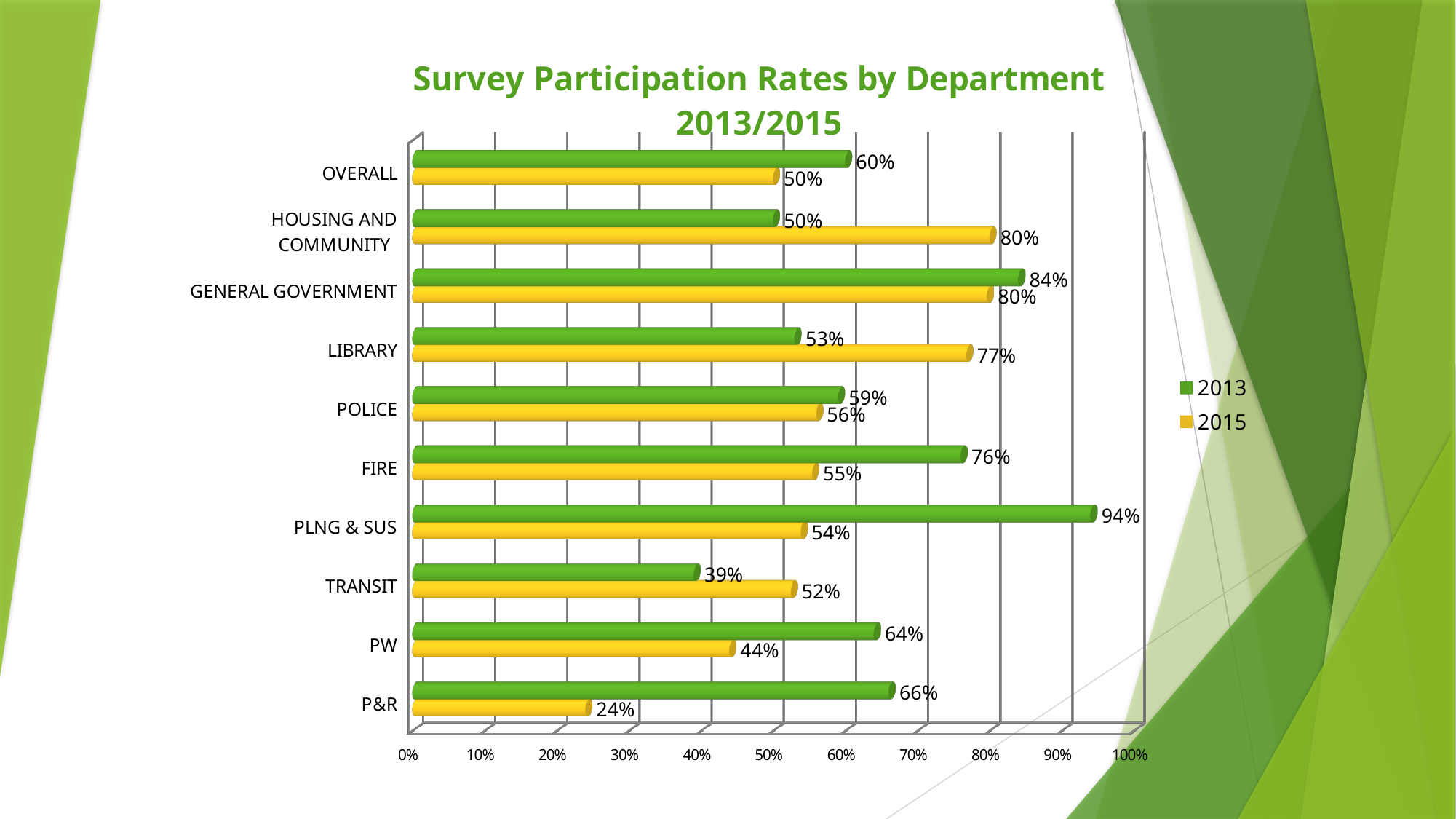
Which department had the lowest 2015 participation rate? P&R What was the 2015 survey participation rate for P&R? 24% What kind of chart is shown on the slide? bar chart How many series does the legend list? 2 What is the difference between the 2013 and 2015 participation rates for FIRE? 21% Which year had the higher participation rate for TRANSIT, 2013 or 2015? 2015 What was the 2013 survey participation rate for PLNG & SUS? 94% What is the title of the chart? Survey Participation Rates by Department 2013/2015 Which department had the highest 2013 participation rate? PLNG & SUS What was the 2015 survey participation rate for LIBRARY? 77% How many departments (categories) are shown on the chart? 10 Is the 2015 participation rate for PW greater or less than 50%? less